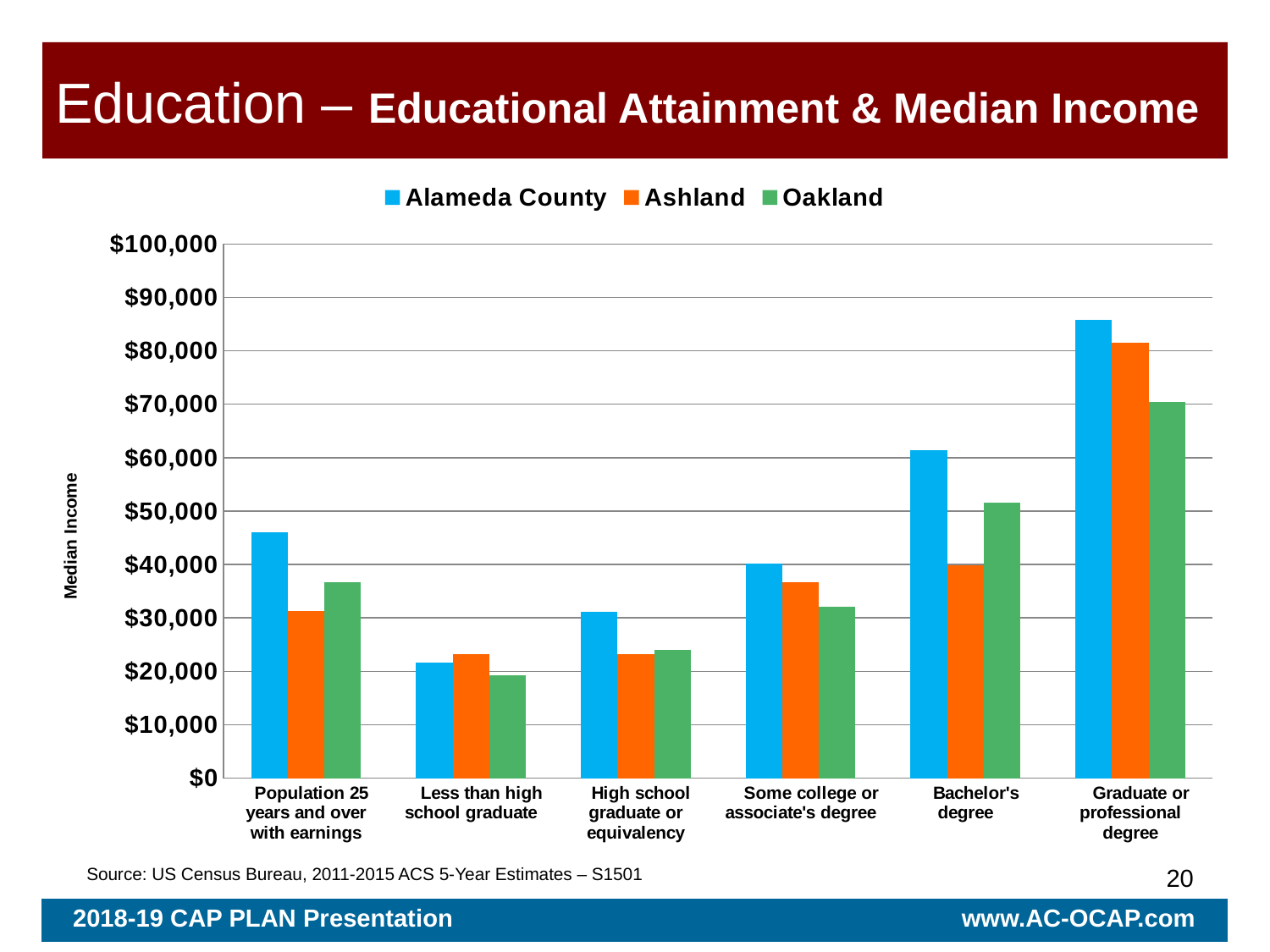
Is the Oakland value for Bachelor's degree greater or less than $60,000? less Is the Alameda County value for Graduate or professional degree greater or less than $80,000? greater For Alameda County, which category has the highest median income? Graduate or professional degree What is the label on the vertical axis? Median Income Is the Ashland value for Bachelor's degree greater or less than $50,000? less How many educational attainment categories are shown on the x axis? 6 For Alameda County, which category has the lowest median income? Less than high school graduate For Population 25 years and over with earnings, which has the higher median income, Ashland or Oakland? Oakland What kind of chart is shown on the slide? bar chart For Bachelor's degree, which has the higher median income, Ashland or Oakland? Oakland How many series does the legend list? 3